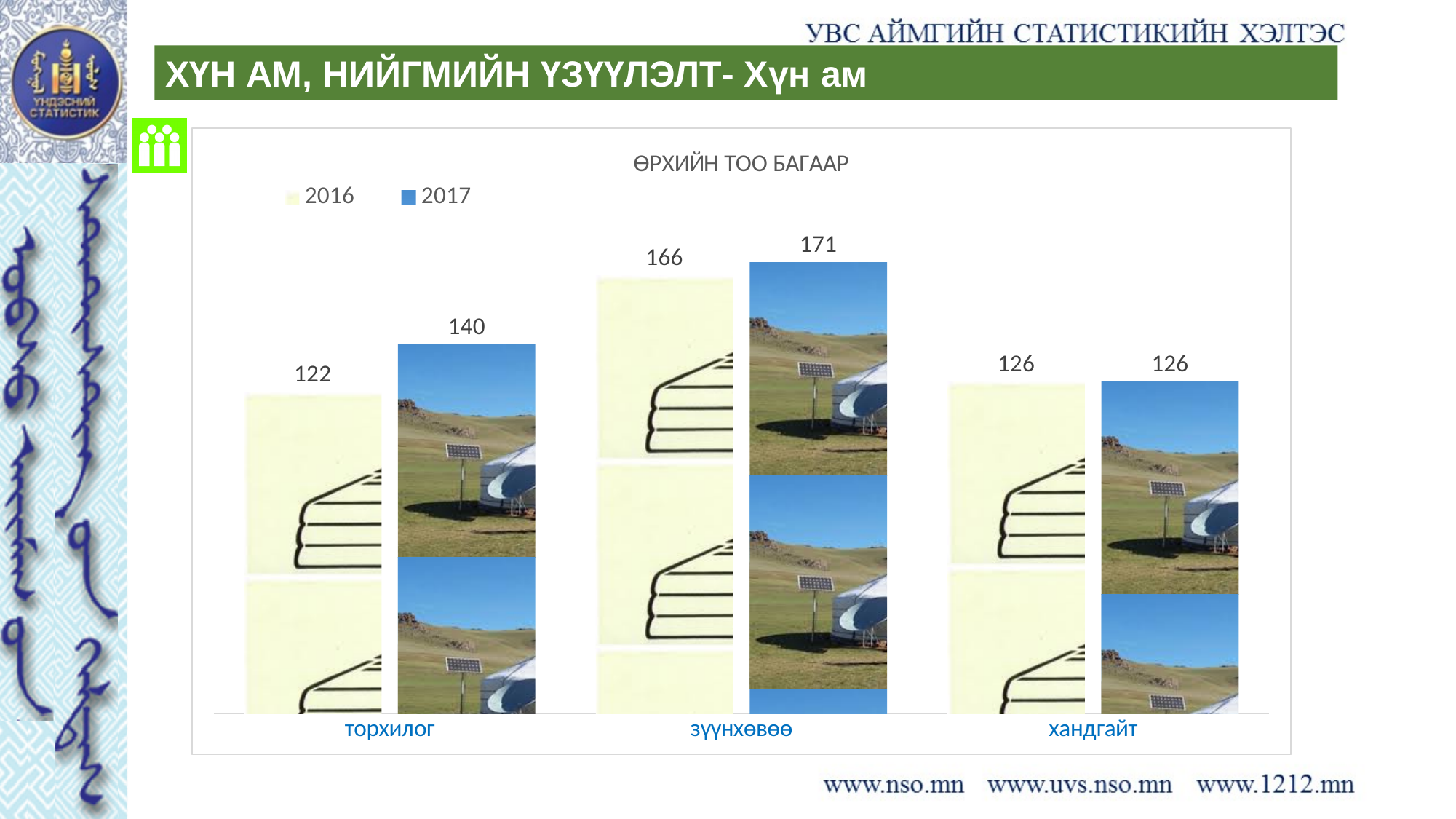
How many categories are shown on the x axis? 3 What is the title of the chart? ӨРХИЙН ТОО БАГААР What is the value for зүүнхөвөө in 2017? 171 What is the value for торхилог in 2017? 140 What is the value for торхилог in 2016? 122 Which category has the lowest value in 2016? торхилог Which category has the highest value in 2017? зүүнхөвөө How many series does the legend list? 2 What is the value for хандгайт in 2016? 126 What is the difference between the 2017 and 2016 values for зүүнхөвөө? 5 Which is larger for зүүнхөвөө, the 2016 value or the 2017 value? 2017 What is the difference between the 2017 and 2016 values for торхилог? 18